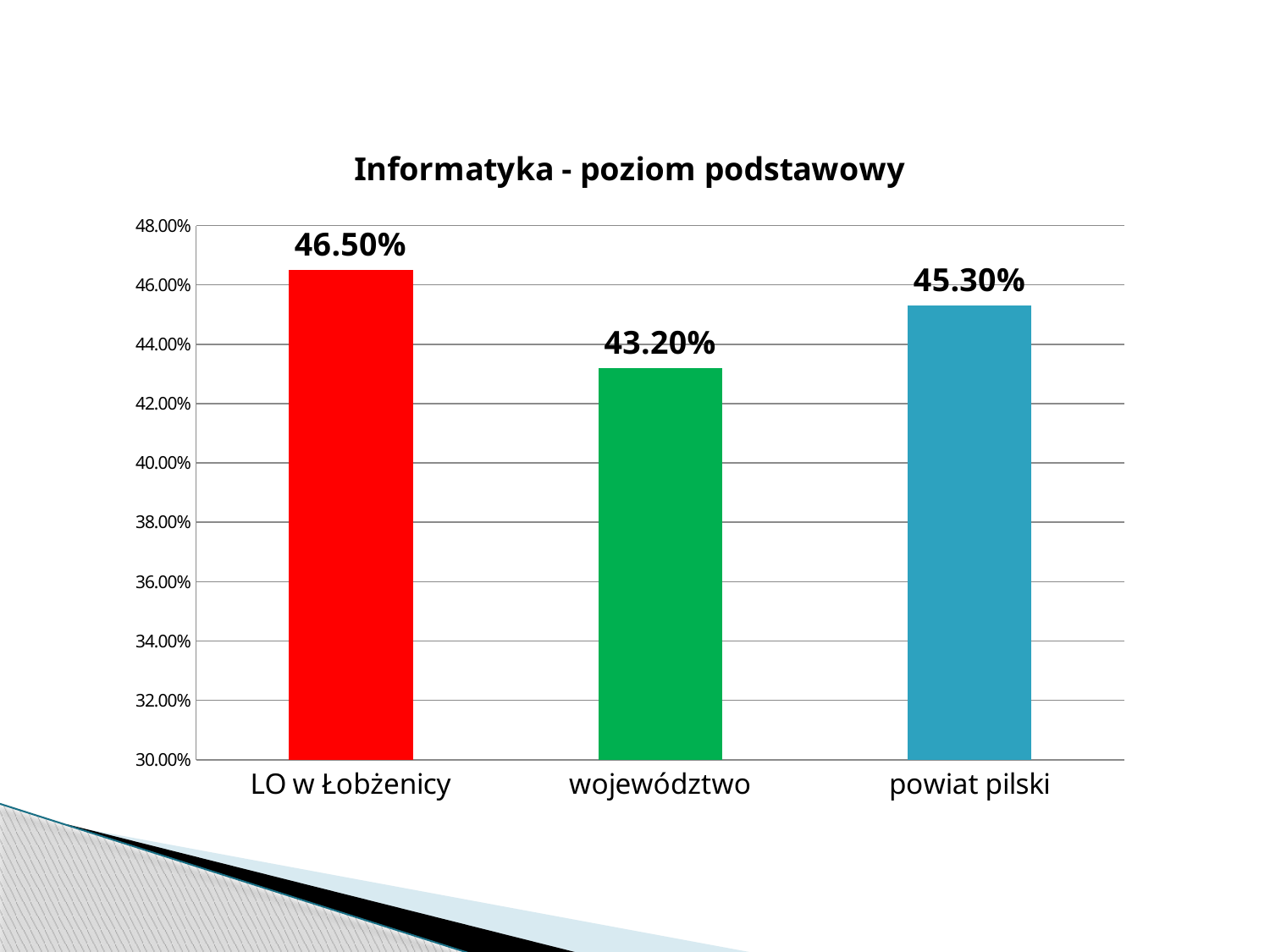
Is the value for województwo greater or less than 44.00%? less How many categories are shown on the chart? 3 What is the difference between the values for LO w Łobżenicy and województwo? 3.30% What is the difference between the values for powiat pilski and województwo? 2.10% What is the title of the chart? Informatyka - poziom podstawowy What is the value for województwo? 43.20% Which category has the highest value? LO w Łobżenicy Which category has the lowest value? województwo What is the value for powiat pilski? 45.30% What is the value for LO w Łobżenicy? 46.50% What kind of chart is shown on the slide? bar chart Which is larger, the value for powiat pilski or the value for województwo? powiat pilski